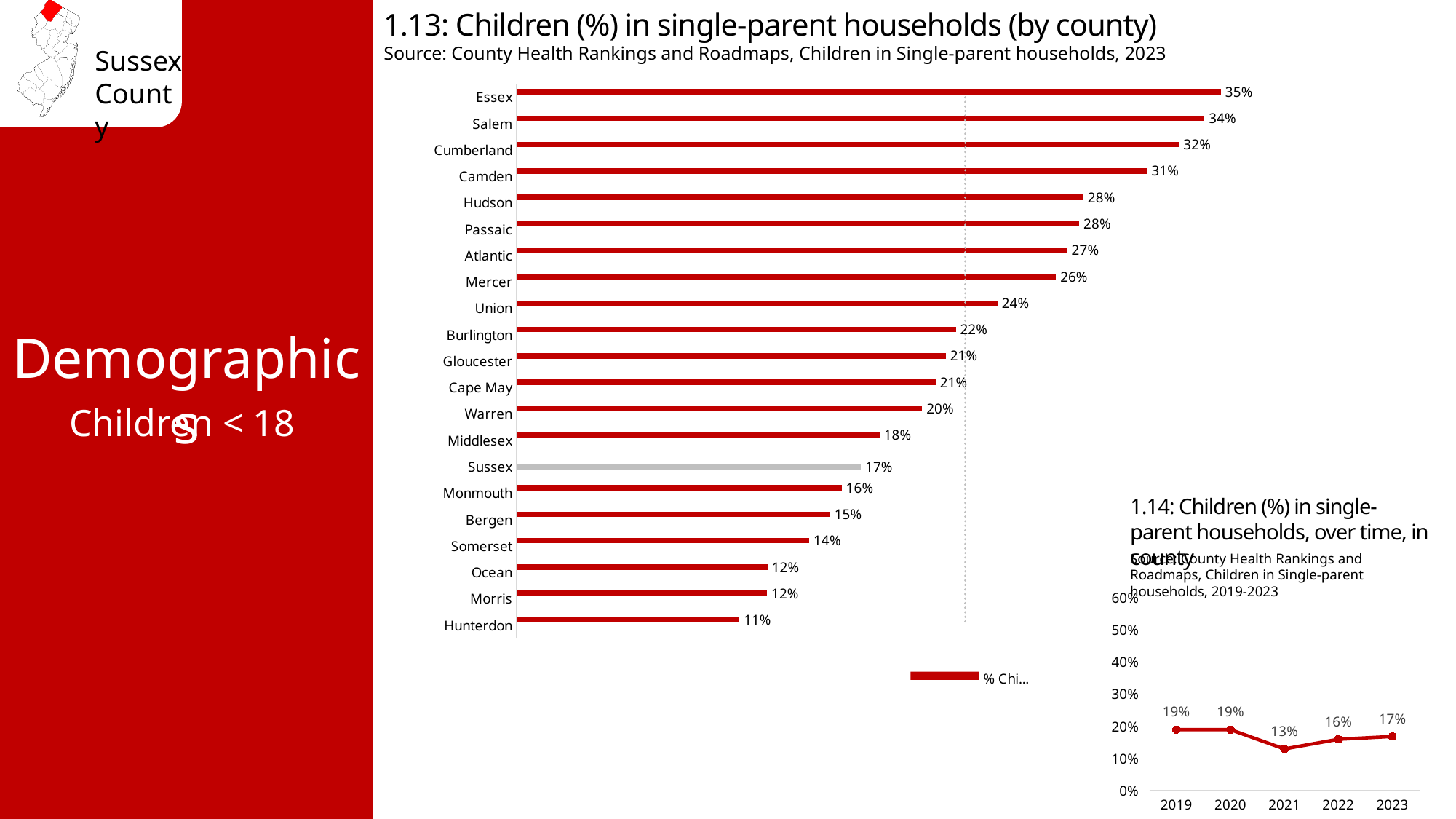
In chart 1.14, which year has the lowest value? 2021 In chart 1.13, which county has the lowest percentage of children in single-parent households? Hunterdon In chart 1.13, what is the difference between the values for Essex and Hunterdon? 24% In chart 1.13, how many counties are shown? 21 In chart 1.13, which is larger, the value for Camden or the value for Mercer? Camden In chart 1.14, what is the difference between the values for 2019 and 2023? 2% In chart 1.13, what is the value for Sussex? 17% What kind of chart is chart 1.13? Bar chart In chart 1.14, what is the value for 2021? 13% In chart 1.13, which county has the highest percentage of children in single-parent households? Essex In chart 1.13, what is the value for Middlesex? 18% In chart 1.14, how many years are plotted? 5